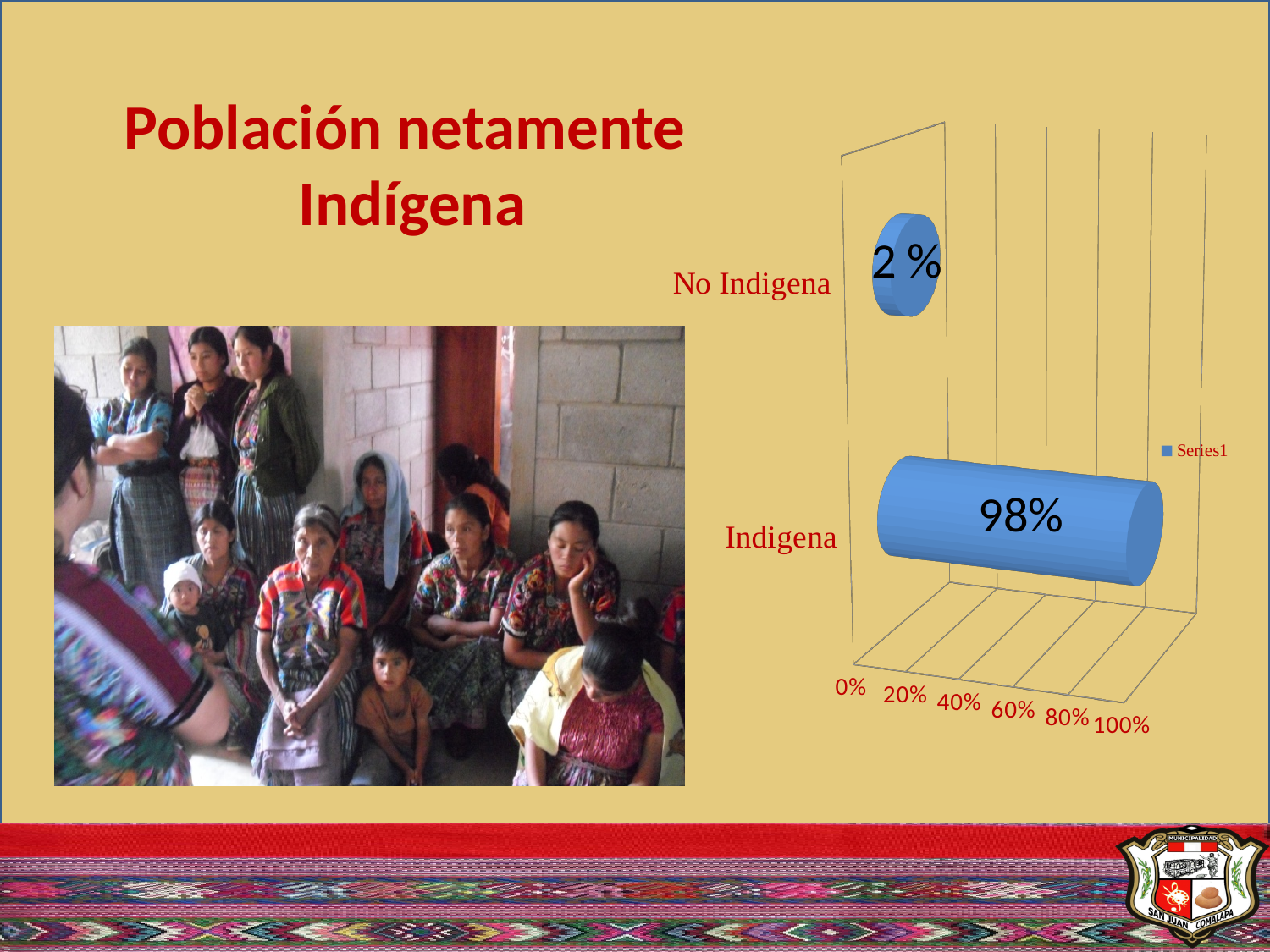
How many categories are shown in the chart? 2 What value is shown for No Indigena? 2 % Which category has the highest value? Indigena Which category has the lowest value? No Indigena Is the value for No Indigena greater or less than 20%? less Is the value for Indigena greater or less than 80%? greater Which is larger, the value for Indigena or the value for No Indigena? Indigena What is the name of the series listed in the legend? Series1 What kind of chart is shown on the slide? bar chart How many series does the legend list? 1 What value is shown for Indigena? 98% What is the difference between the values for Indigena and No Indigena? 96%